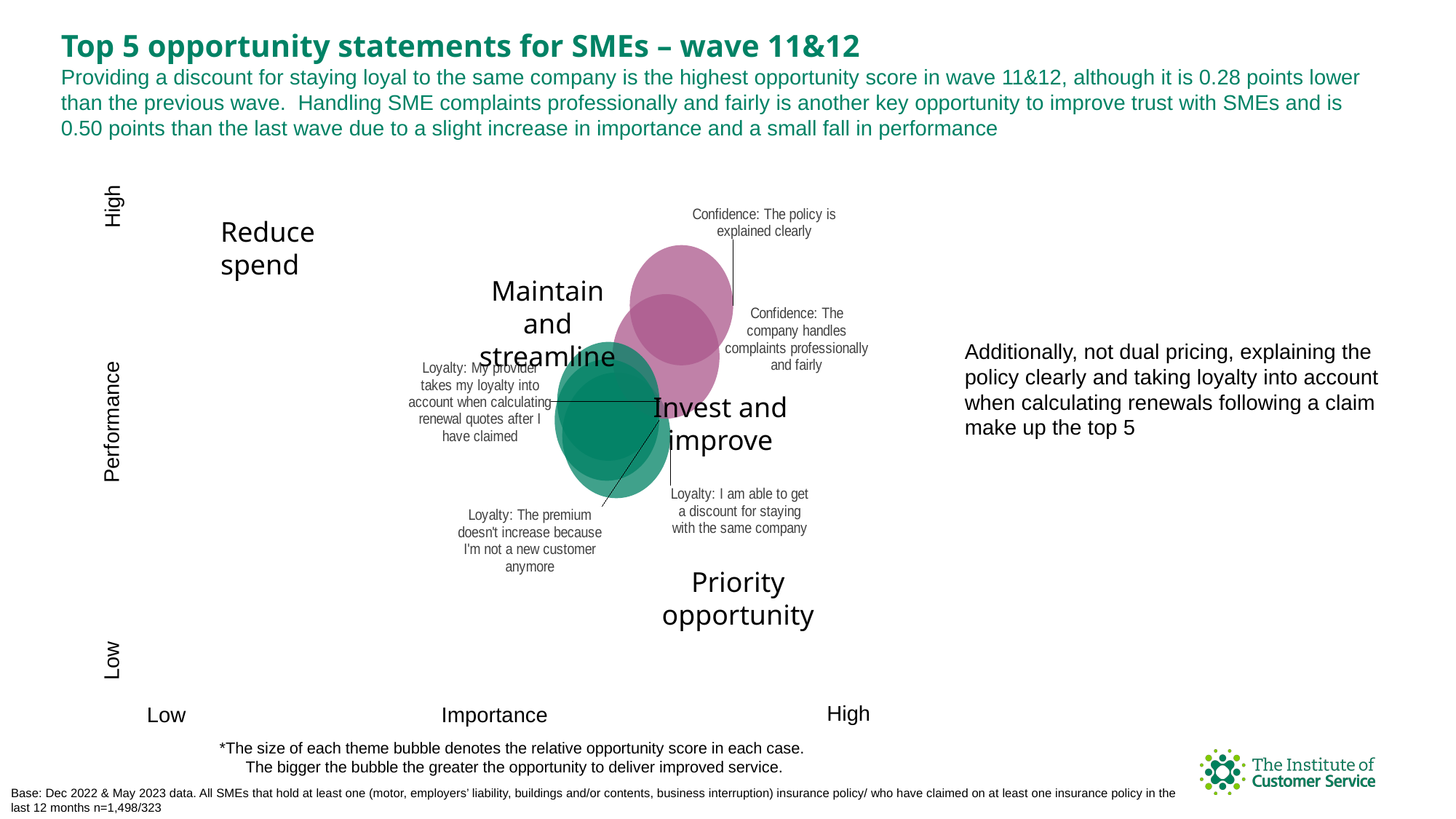
How many of the plotted statements belong to the Loyalty theme? 3 What kind of chart is shown on the slide? Bubble chart What does the vertical axis of the chart represent? Performance According to the chart note, what does the size of each bubble denote? The relative opportunity score Which statement's bubble is positioned highest on the Performance axis? Confidence: The policy is explained clearly What does the horizontal axis of the chart represent? Importance How many statement bubbles are plotted on the chart? 5 How many of the plotted statements belong to the Confidence theme? 2 Is the bubble for 'Confidence: The policy is explained clearly' positioned higher or lower on the Performance axis than the bubble for 'Loyalty: I am able to get a discount for staying with the same company'? higher